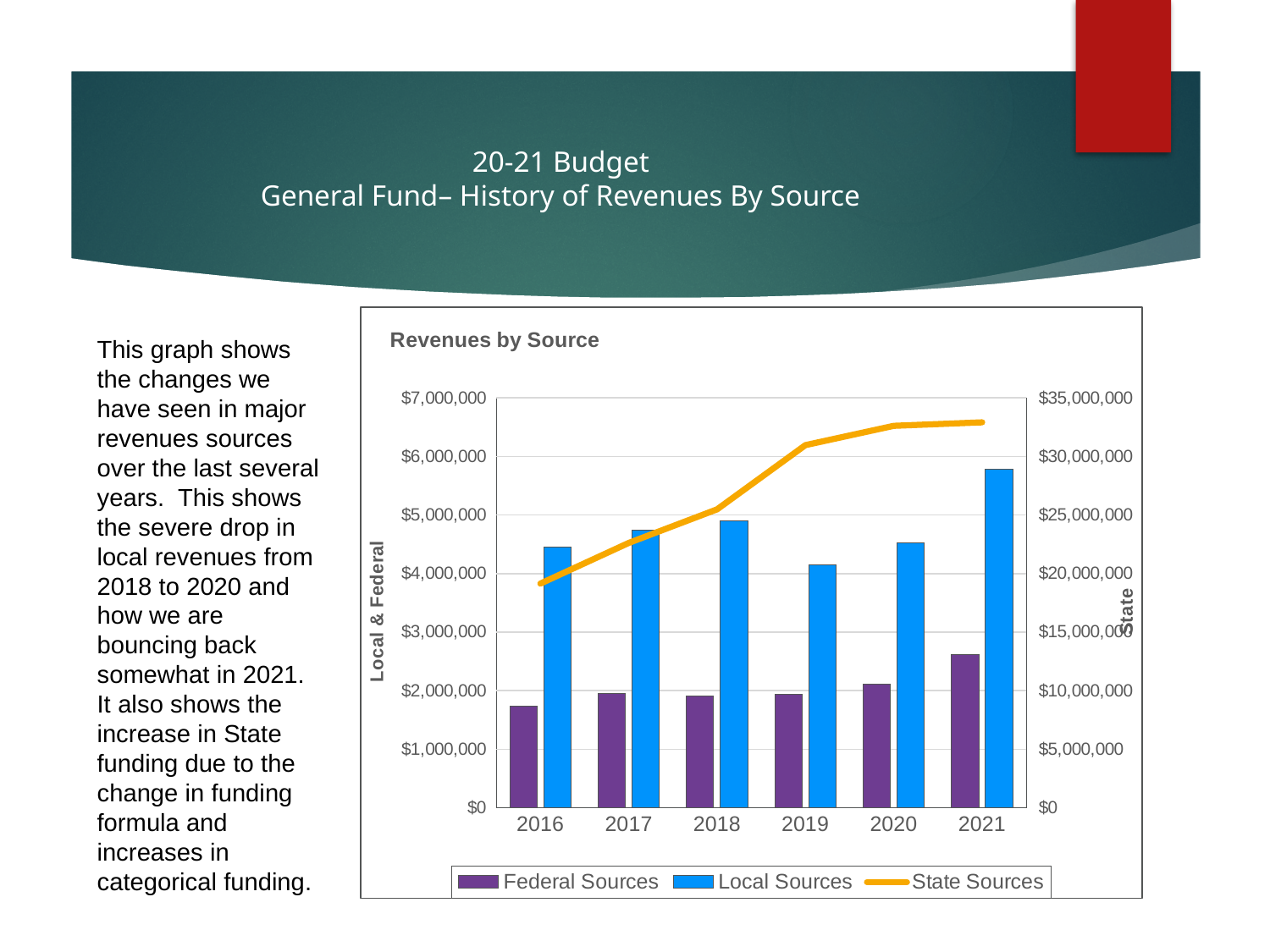
Do State Sources rise or fall from 2016 to 2021? rise Which is larger, Local Sources in 2018 or Local Sources in 2019? 2018 What kind of chart is shown on the slide? A combined bar and line chart Is the value for Federal Sources in 2016 greater or less than $2,000,000? less How many series does the legend of the Revenues by Source chart list? 3 How many years are shown on the x axis of the Revenues by Source chart? 6 Is the value for State Sources in 2021 greater or less than $30,000,000? greater In which year are Local Sources lowest? 2019 In which year are Local Sources highest? 2021 In which year are Federal Sources highest? 2021 Is the value for Local Sources in 2021 greater or less than $5,000,000? greater In which year are Federal Sources lowest? 2016